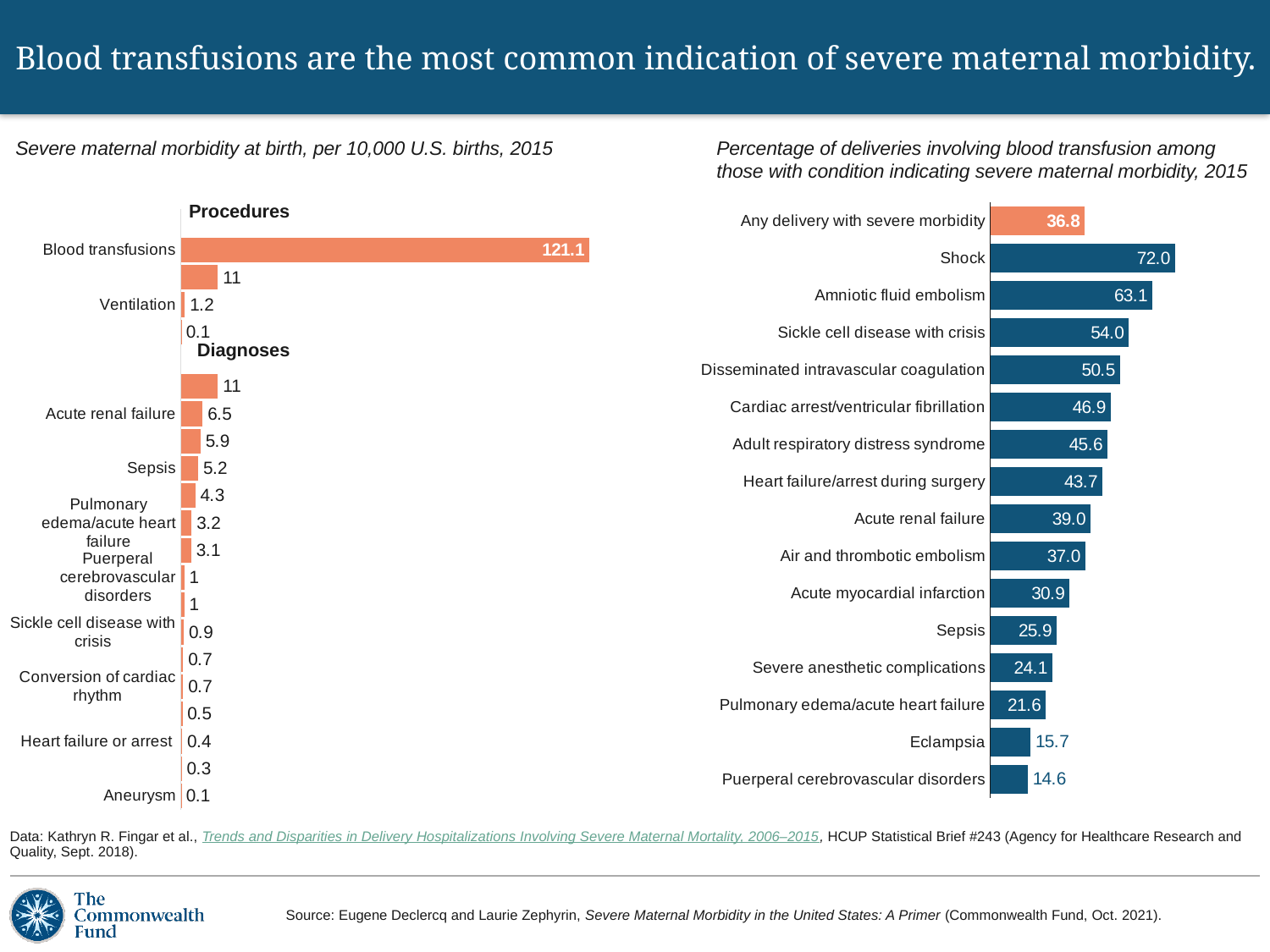
How many categories are shown in the right-hand chart on the percentage of deliveries involving blood transfusion? 16 In the right-hand chart on the percentage of deliveries involving blood transfusion, which category has the lowest value? Puerperal cerebrovascular disorders In the right-hand chart on the percentage of deliveries involving blood transfusion, what is the value for Any delivery with severe morbidity? 36.8 In the chart titled 'Severe maternal morbidity at birth, per 10,000 U.S. births, 2015', which is larger: Ventilation or Heart failure or arrest? Ventilation In the chart titled 'Severe maternal morbidity at birth, per 10,000 U.S. births, 2015', what is the value for Acute renal failure? 6.5 What kind of chart is the right-hand chart on the percentage of deliveries involving blood transfusion? Bar chart In the chart titled 'Severe maternal morbidity at birth, per 10,000 U.S. births, 2015', what is the difference between Acute renal failure and Sepsis? 1.3 In the chart titled 'Severe maternal morbidity at birth, per 10,000 U.S. births, 2015', what is the value for Blood transfusions? 121.1 In the right-hand chart on the percentage of deliveries involving blood transfusion, what is the value for Shock? 72.0 In the right-hand chart on the percentage of deliveries involving blood transfusion, what is the difference between Shock and Amniotic fluid embolism? 8.9 In the chart titled 'Severe maternal morbidity at birth, per 10,000 U.S. births, 2015', what is the value for Sepsis? 5.2 In the chart titled 'Severe maternal morbidity at birth, per 10,000 U.S. births, 2015', which category has the highest value? Blood transfusions